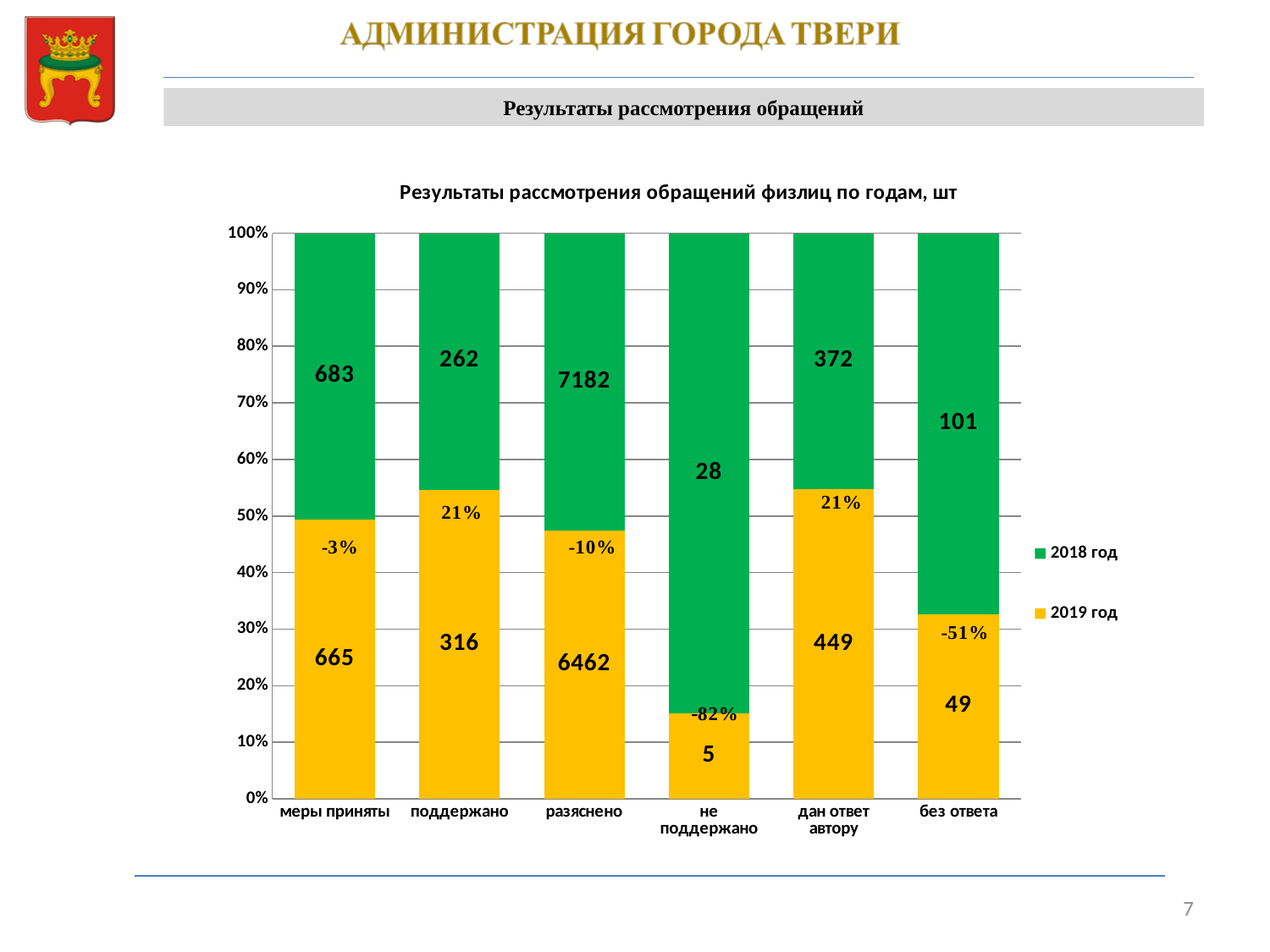
What is the value for 2018 год in the category 'дан ответ автору'? 372 What kind of chart is shown on the slide? Stacked bar chart How many series does the legend list? 2 What is the value for 2019 год in the category 'не поддержано'? 5 How many categories are shown on the x axis? 6 Which category has the highest value for 2019 год? разяснено Which is larger in the category 'меры приняты': the 2018 год value or the 2019 год value? 2018 год What is the title of the chart? Результаты рассмотрения обращений физлиц по годам, шт What is the difference between the 2018 год and 2019 год values in the category 'поддержано'? 54 Which category has the lowest value for 2018 год? не поддержано What is the value for 2018 год in the category 'разяснено'? 7182 What is the value for 2019 год in the category 'без ответа'? 49